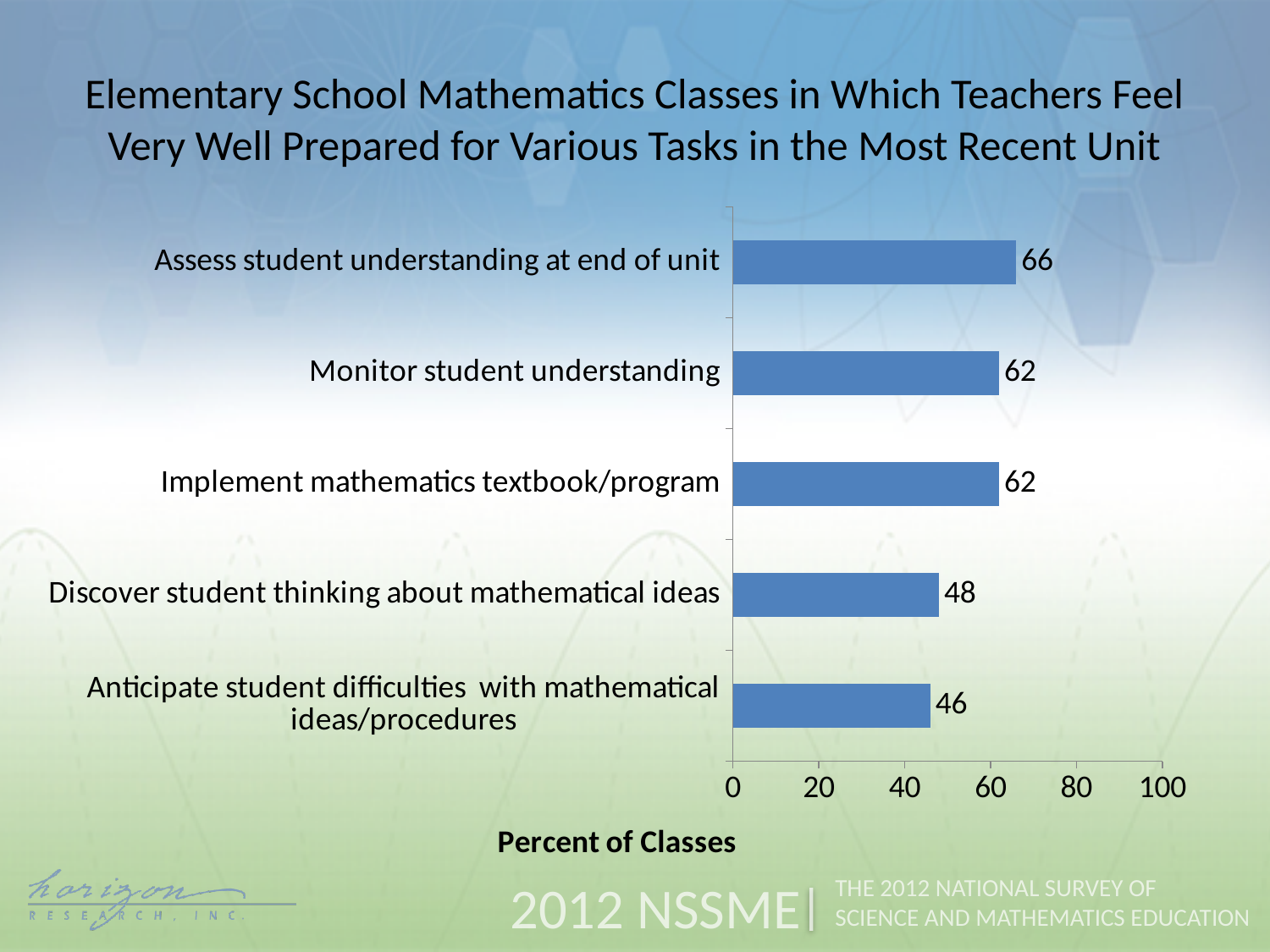
How many categories are shown in the chart? 5 What is the value for "Monitor student understanding"? 62 Which category has the lowest value? Anticipate student difficulties with mathematical ideas/procedures What is the difference between the values for "Assess student understanding at end of unit" and "Anticipate student difficulties with mathematical ideas/procedures"? 20 What kind of chart is shown on the slide? Bar chart What is the value for "Assess student understanding at end of unit"? 66 Which is larger, the value for "Implement mathematics textbook/program" or the value for "Discover student thinking about mathematical ideas"? Implement mathematics textbook/program Is the value for "Monitor student understanding" greater or less than 40? greater What is the value for "Discover student thinking about mathematical ideas"? 48 Which category has the highest value? Assess student understanding at end of unit What is the label of the horizontal axis? Percent of Classes What is the value for "Anticipate student difficulties with mathematical ideas/procedures"? 46